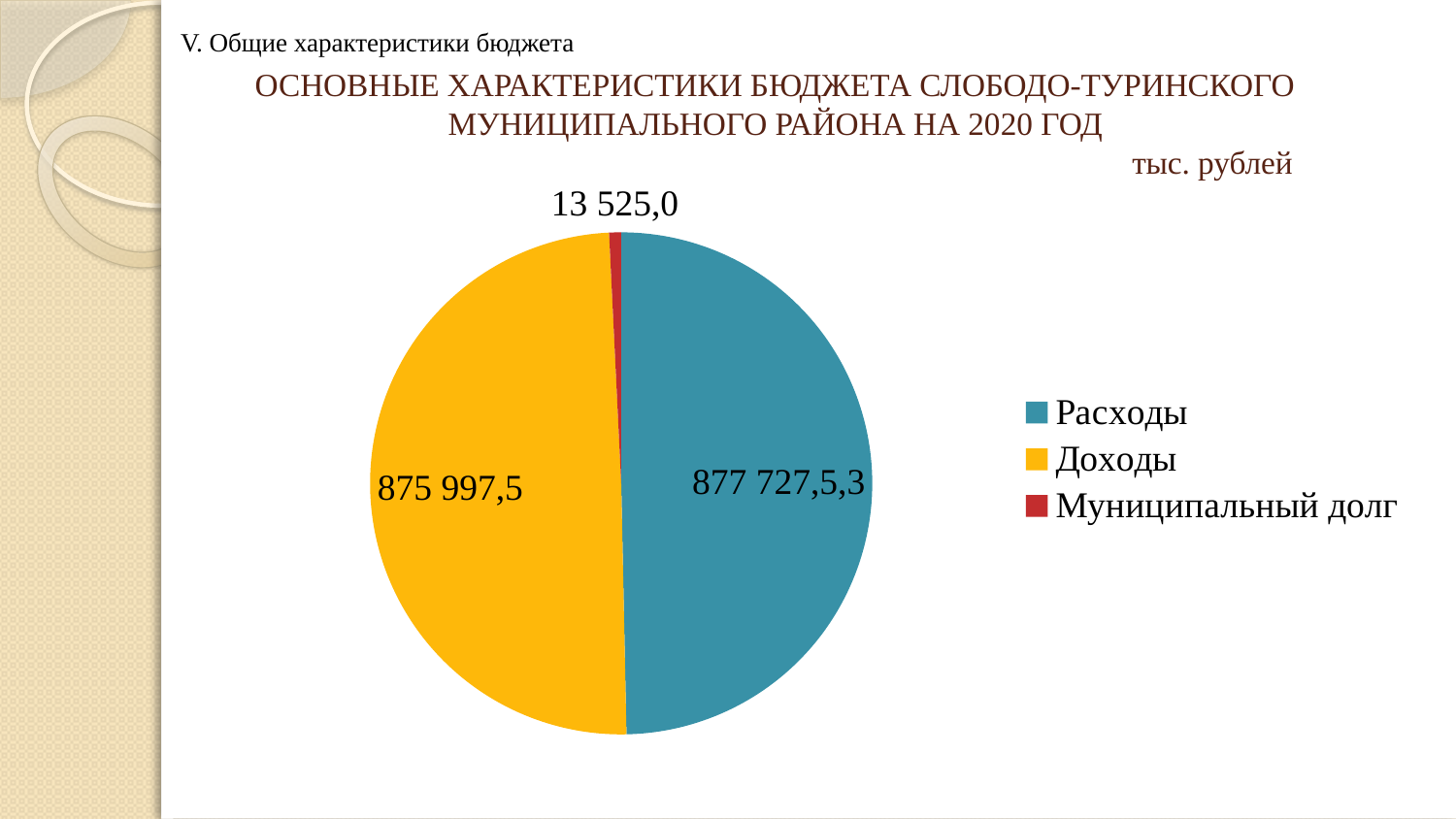
What is the difference between the values for Доходы and Муниципальный долг? 862 472,5 What colour is the Доходы slice? Yellow What kind of chart is shown on the slide? Pie chart Which category has the smallest slice of the pie? Муниципальный долг What is the value shown for Муниципальный долг? 13 525,0 In what units are the values on the chart expressed, according to the slide? тыс. рублей How many slices does the pie chart have? 3 What is the value shown for Доходы? 875 997,5 Which is larger, Доходы or Муниципальный долг? Доходы What is the data label shown on the Расходы slice? 877 727,5,3 How many entries does the legend list? 3